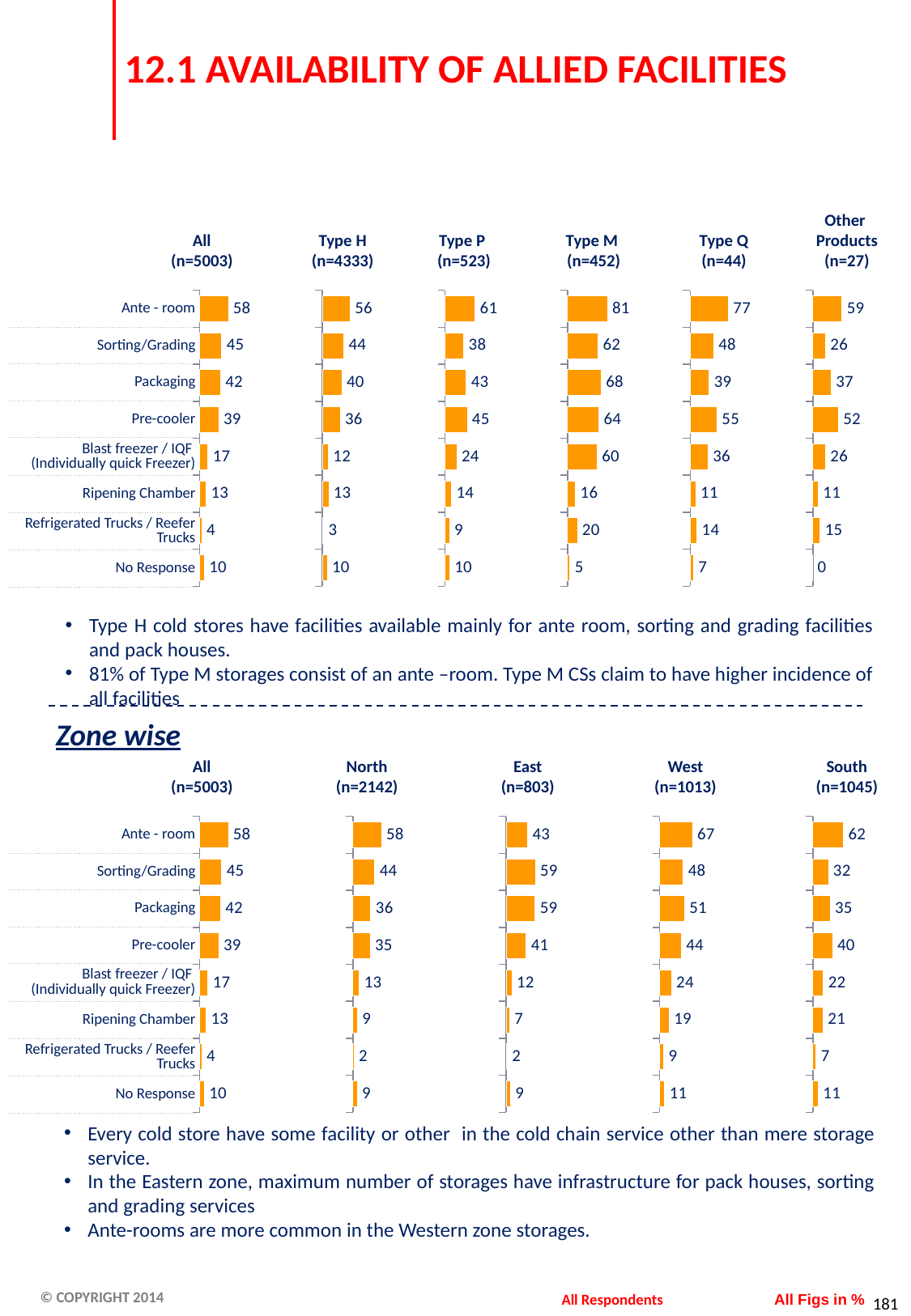
In the top set of charts, what is the value for Blast freezer / IQF in the Type P (n=523) chart? 24 In the top set of charts (by type), what is the value for Ante - room in the Type M (n=452) chart? 81 How many facility categories are listed on the vertical axis of each chart in the Zone wise section? 8 What type of chart is used to show the availability of allied facilities on this slide? Bar chart In the top set of charts, which facility has the highest value in the Type Q (n=44) chart? Ante - room In the Zone wise charts, what is the value for Sorting/Grading in the East (n=803) chart? 59 In the Zone wise charts, which is larger: Ripening Chamber in South or Ripening Chamber in North? South In the Zone wise charts, what is the value for Refrigerated Trucks / Reefer Trucks in the West (n=1013) chart? 9 In the Zone wise charts, which zone has the highest Ante - room value? West In the top set of charts, which category has the lowest value in the Other Products (n=27) chart? No Response In the top set of charts, what is the difference between the Ante - room values for Type M (81) and Type H (56)? 25 In the Zone wise charts, what is the difference between Packaging in East (59) and Packaging in North (36)? 23